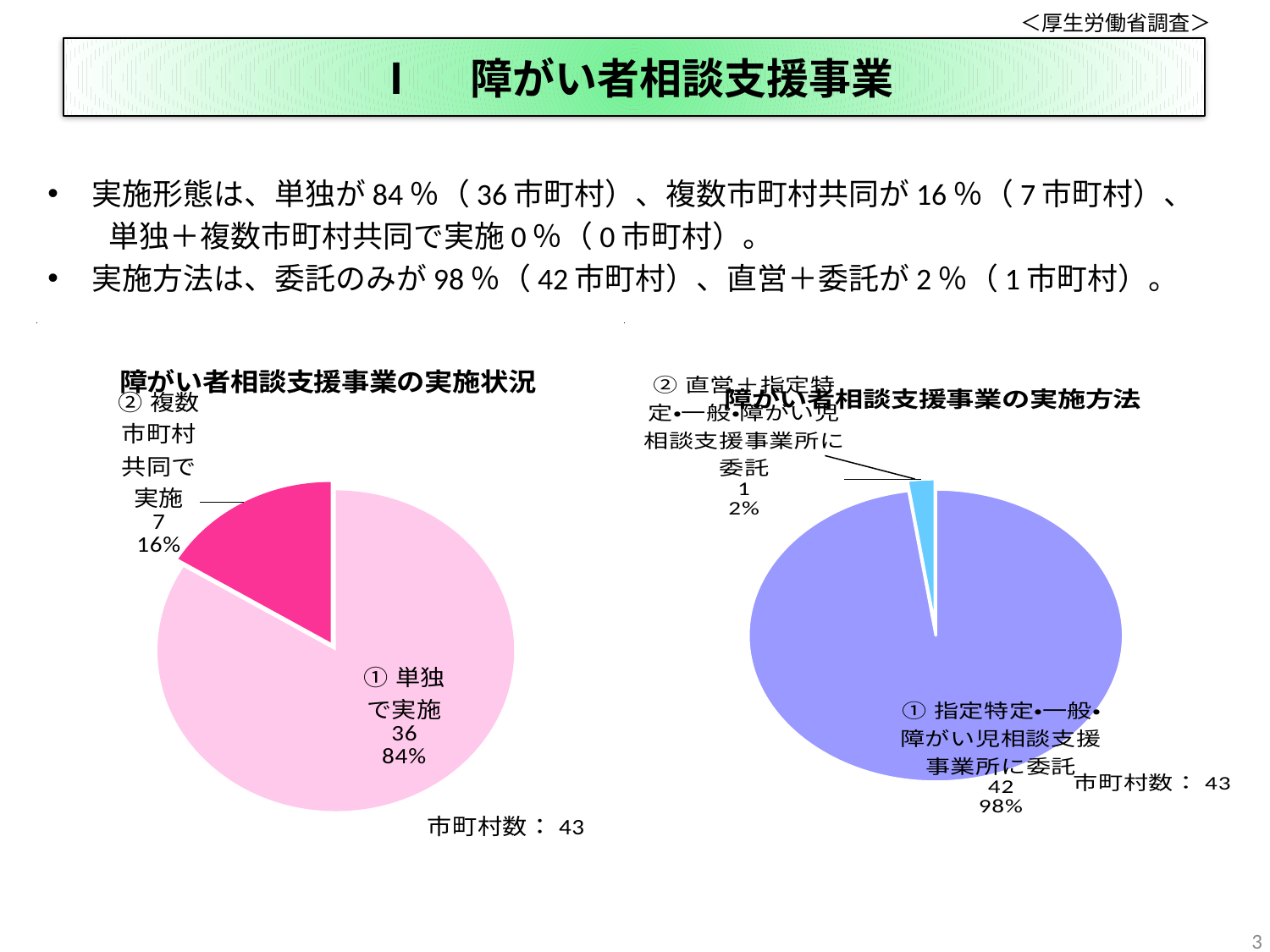
In the right chart titled 障がい者相談支援事業の実施方法, which slice is the smallest? ② 直営＋指定特定・一般・障がい児相談支援事業所に委託 In the left chart titled 障がい者相談支援事業の実施状況, what percentage share does the ② 複数市町村共同で実施 slice have? 16% In the left chart titled 障がい者相談支援事業の実施状況, which slice is the largest? ① 単独で実施 Which is larger: the ② slice in the left chart (複数市町村共同で実施) or the ② slice in the right chart (直営＋委託)? ② 複数市町村共同で実施 (left chart) In the right chart titled 障がい者相談支援事業の実施方法, what percentage share does the ② 直営＋指定特定・一般・障がい児相談支援事業所に委託 slice have? 2% In the right chart titled 障がい者相談支援事業の実施方法, what is the total number of municipalities shown (市町村数)? 43 In the left chart titled 障がい者相談支援事業の実施状況, what is the difference in municipality count between ① 単独で実施 and ② 複数市町村共同で実施? 29 In the right chart titled 障がい者相談支援事業の実施方法, what colour is the ① 指定特定・一般・障がい児相談支援事業所に委託 slice? purple (blue-violet) In the left chart titled 障がい者相談支援事業の実施状況, what kind of chart is shown? pie chart In the left chart titled 障がい者相談支援事業の実施状況, how many municipalities are in the ① 単独で実施 slice? 36 In the left chart titled 障がい者相談支援事業の実施状況, how many slices does the pie have? 2 In the right chart titled 障がい者相談支援事業の実施方法, how many municipalities are in the ① 指定特定・一般・障がい児相談支援事業所に委託 slice? 42